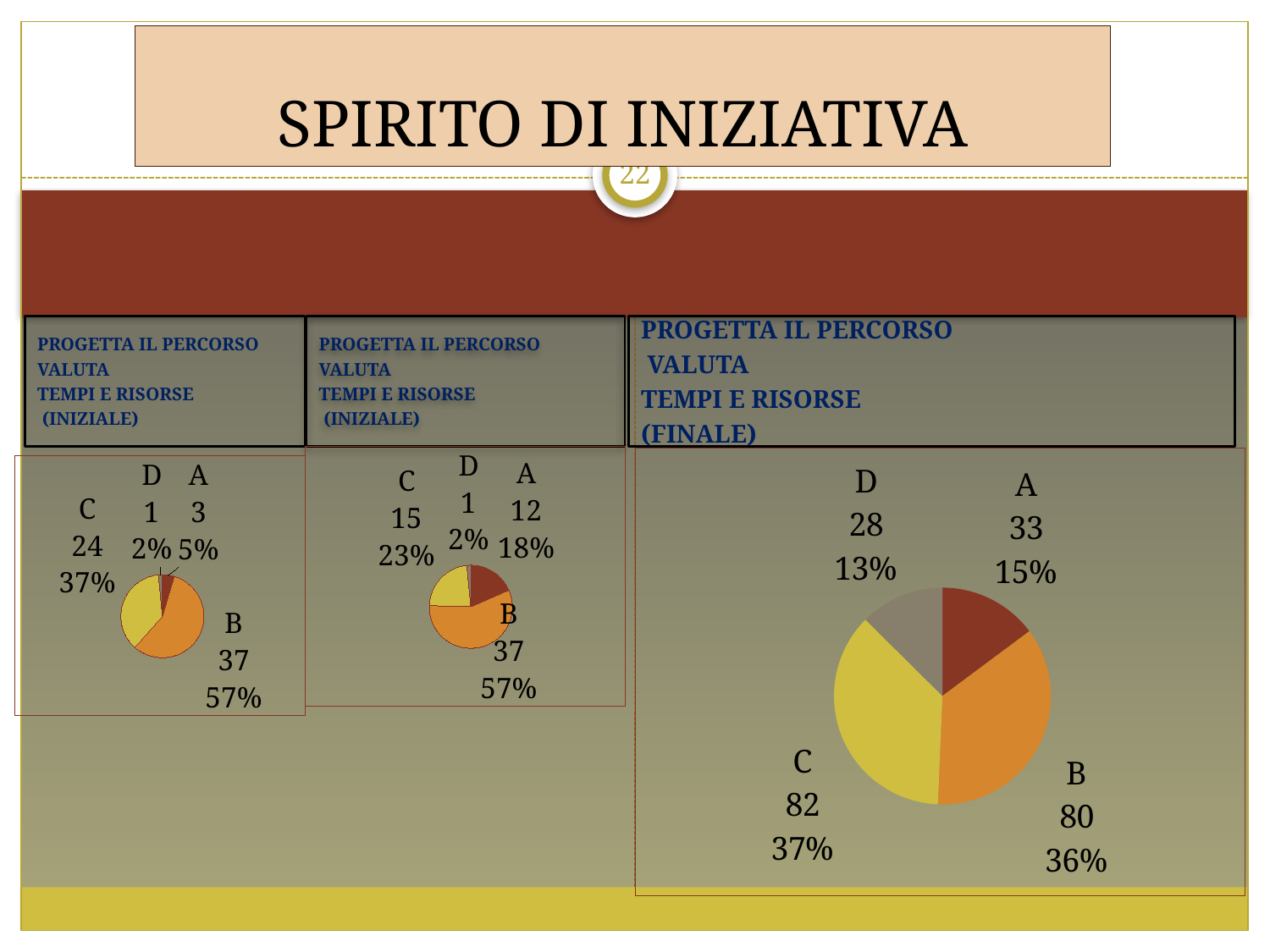
In the leftmost pie chart (INIZIALE), which category has the highest value? B In the rightmost pie chart (FINALE), which category has the lowest value? D In the leftmost pie chart (INIZIALE), what percentage share does category C have? 37% In the middle pie chart (INIZIALE), which is larger, the value for A or the value for C? C How many categories does the rightmost pie chart (FINALE) show? 4 In the rightmost pie chart (FINALE), what is the value for category C? 82 In the middle pie chart (INIZIALE), what is the value for category A? 12 In the rightmost pie chart (FINALE), what is the difference between the values for A and D? 5 What kind of chart is used in the rightmost chart (FINALE)? Pie chart In the rightmost pie chart (FINALE), what percentage share does category B have? 36% In the leftmost pie chart (INIZIALE), what is the value for category B? 37 In the middle pie chart (INIZIALE), what is the difference between the values for B and C? 22